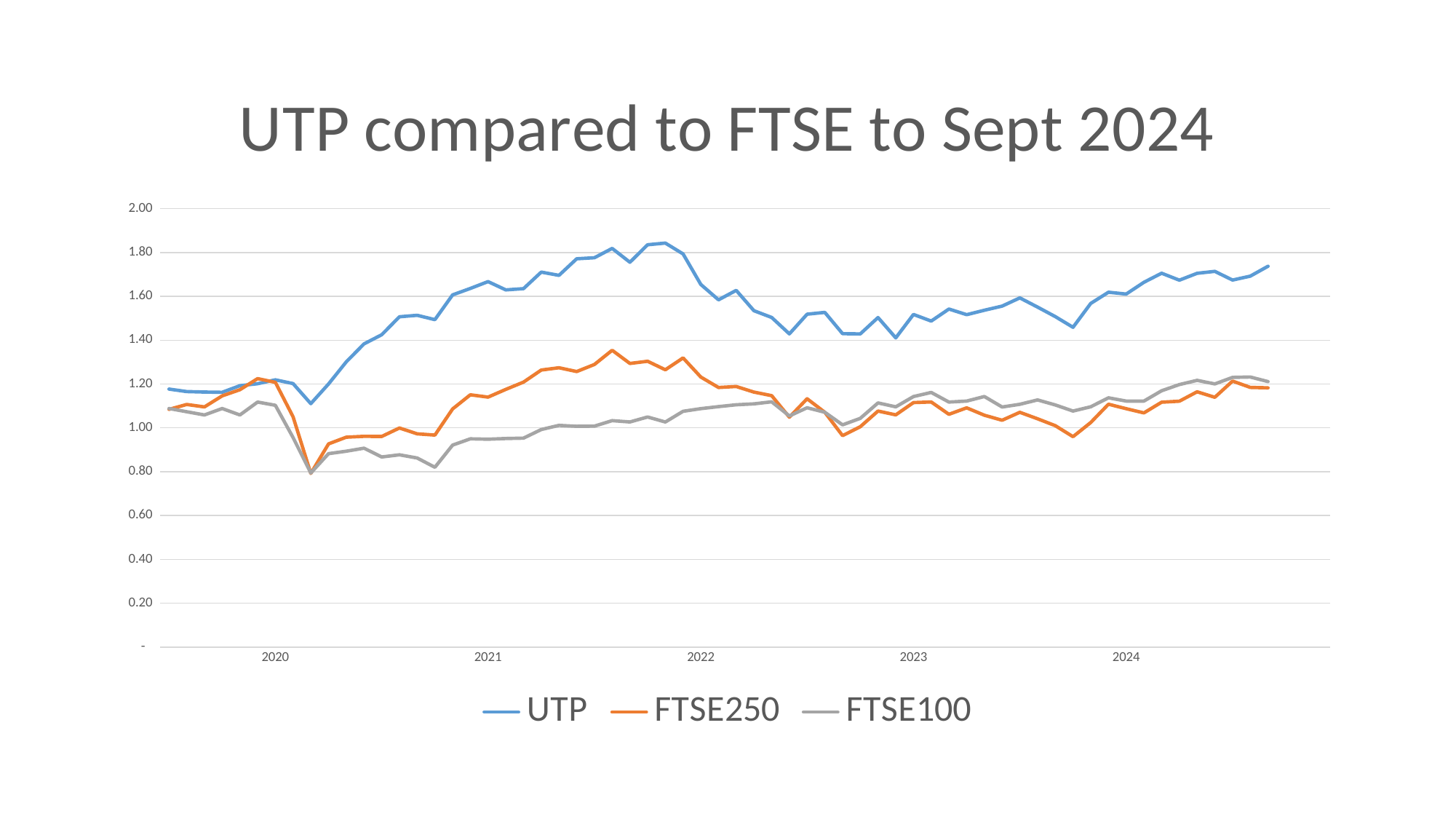
Is the value for FTSE100 at the 2021 tick greater or less than 1.00? less What kind of chart is shown on the slide? line chart Which series has the highest value at the end of the chart (Sept 2024)? UTP How many year labels are shown on the x axis? 5 At the 2022 tick, which is larger, UTP or FTSE250? UTP What is the title of the chart? UTP compared to FTSE to Sept 2024 Does the UTP line rise or fall between the 2020 tick and the 2021 tick? rise Is the peak value of UTP greater or less than 1.80? greater How many series does the legend list? 3 Which series has the lowest value at the 2021 tick? FTSE100 Which series is drawn in orange? FTSE250 Is the value for UTP at the 2022 tick greater or less than 1.40? greater